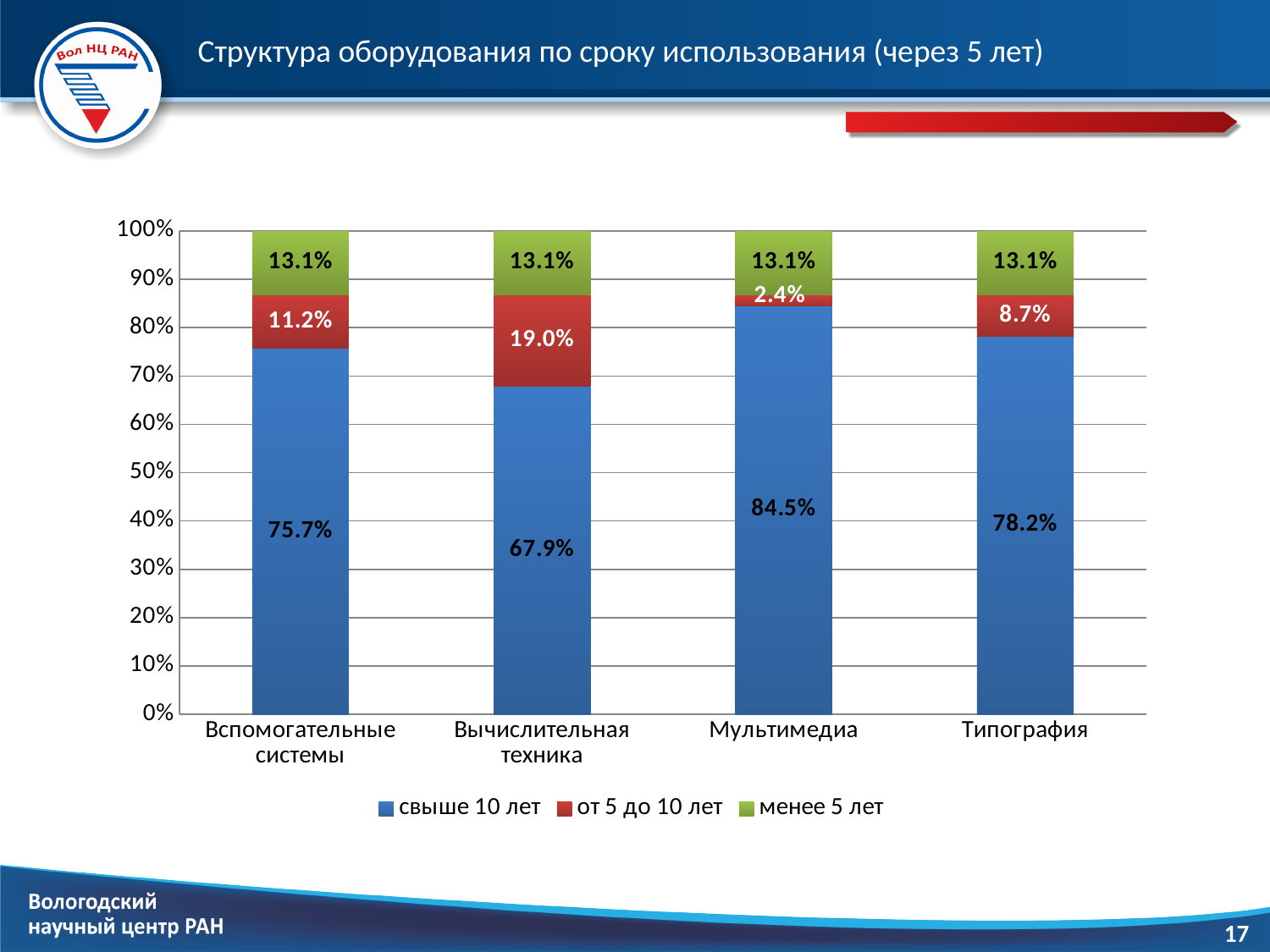
What share of equipment in the 'Типография' category is 'от 5 до 10 лет'? 8.7% What share of equipment in the 'Вычислительная техника' category is 'от 5 до 10 лет'? 19.0% What share of equipment in the 'Вспомогательные системы' category is 'свыше 10 лет'? 75.7% Which is larger: the 'от 5 до 10 лет' share for 'Вспомогательные системы' or for 'Типография'? Вспомогательные системы What is the difference between the 'свыше 10 лет' shares for 'Мультимедиа' and 'Вычислительная техника'? 16.6% What is the title of the chart? Структура оборудования по сроку использования (через 5 лет) Which category has the highest share of equipment 'свыше 10 лет'? Мультимедиа How many categories are shown on the x axis? 4 How many series does the legend list? 3 What share of equipment in the 'Мультимедиа' category is 'свыше 10 лет'? 84.5% What type of chart is shown on the slide? Stacked bar chart Which category has the lowest share of equipment 'от 5 до 10 лет'? Мультимедиа